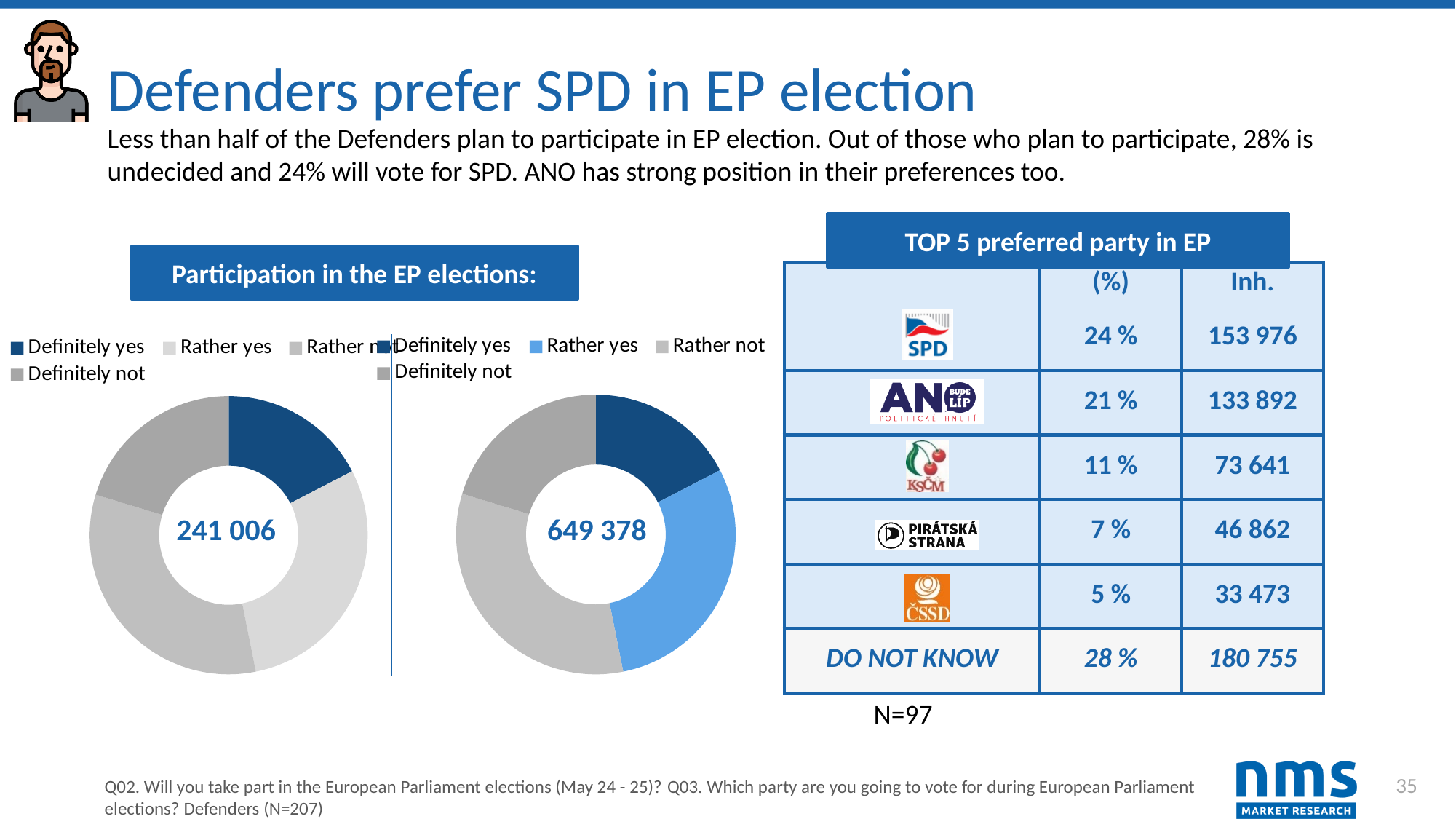
What colour represents 'Rather yes' in the right doughnut chart? light blue In the right doughnut chart, which slice is the smallest? Definitely yes In the left doughnut chart, which slice is larger: 'Rather not' or 'Definitely yes'? Rather not In the right doughnut chart, which slice is larger: 'Rather yes' or 'Definitely yes'? Rather yes What kind of chart is used for the left chart under 'Participation in the EP elections'? doughnut chart In the left doughnut chart, which slice is the smallest? Definitely yes What is the heading shown above the two doughnut charts? Participation in the EP elections: How many slices does the right doughnut chart have? 4 How many entries does the legend of the left doughnut chart list? 4 What number is printed in the centre of the right doughnut chart? 649 378 What number is printed in the centre of the left doughnut chart? 241 006